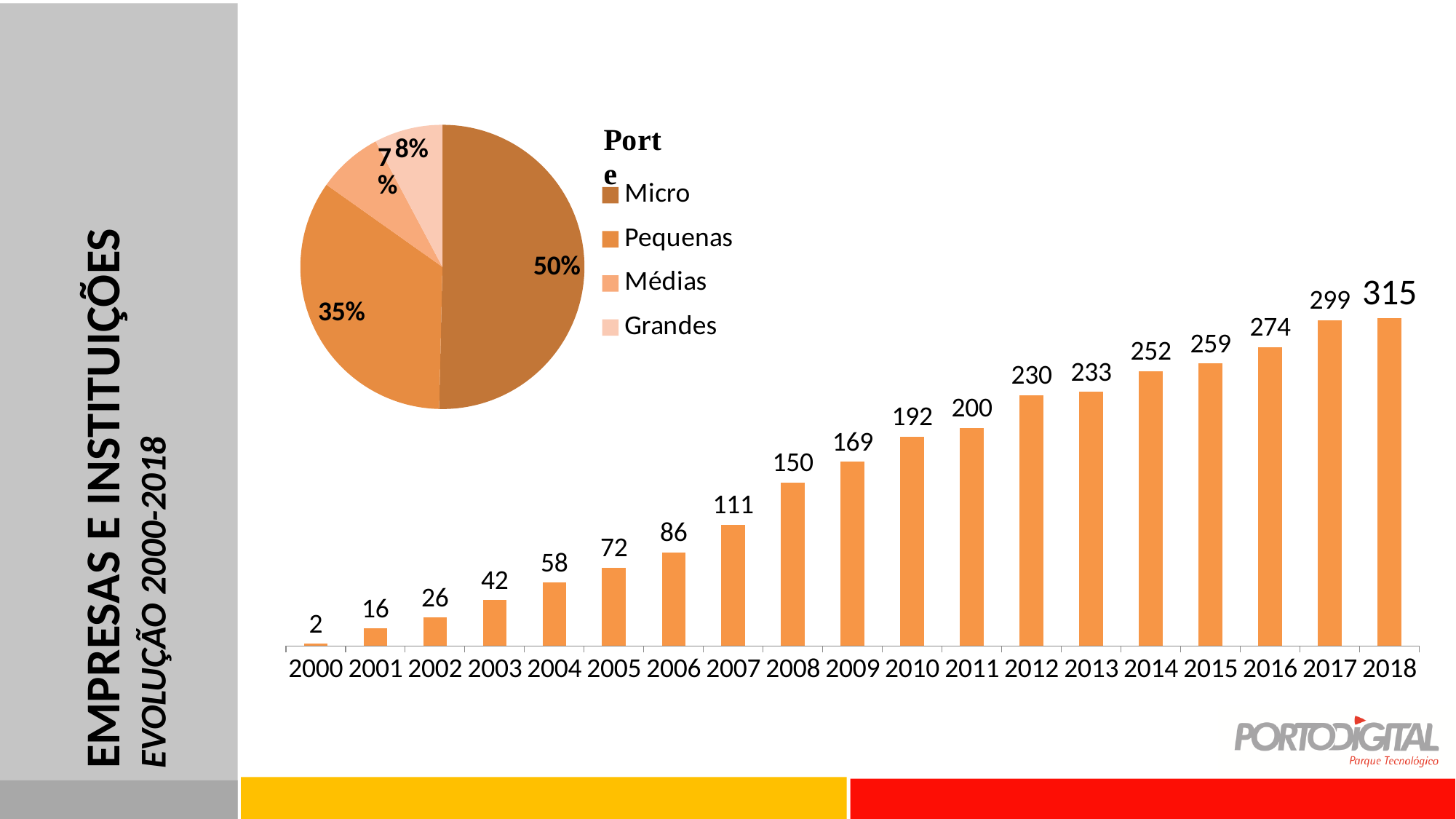
In the bar chart, which year has the highest value? 2018 In the pie chart titled Porte, what share does Micro have? 50% In the bar chart, which is larger, the value for 2008 or the value for 2009? 2009 How many years are shown on the x axis of the bar chart? 19 In the bar chart, which year has the lowest value? 2000 In the bar chart, what is the difference between the values for 2018 and 2017? 16 In the bar chart, what is the value for 2003? 42 How many entries does the legend of the pie chart titled Porte list? 4 In the bar chart, what is the value for 2010? 192 What kind of chart is the chart at the bottom of the slide? bar chart In the pie chart titled Porte, what share does Pequenas have? 35% In the bar chart, do the values rise or fall from 2000 to 2018? rise